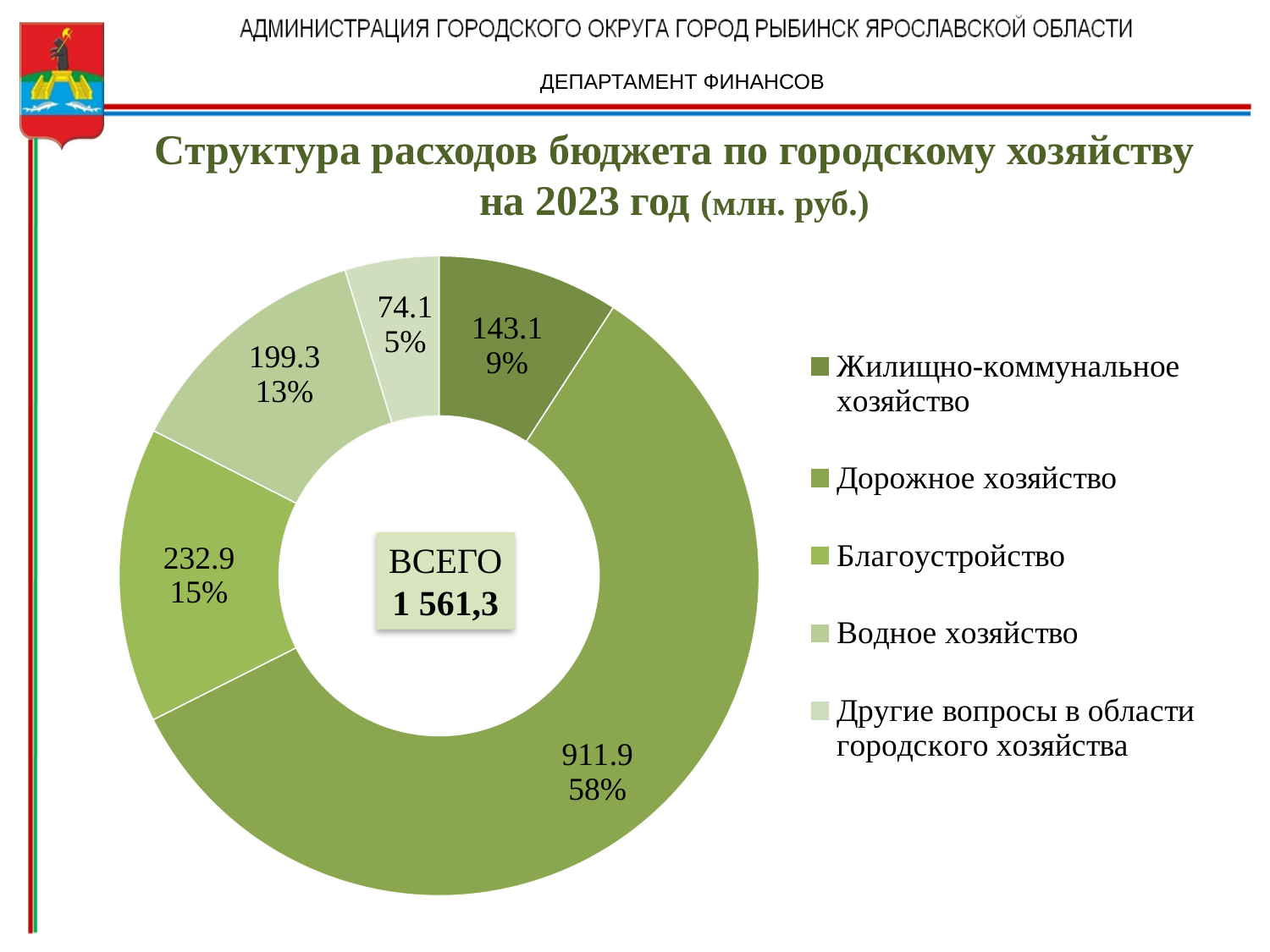
What total (ВСЕГО) is shown in the centre of the chart? 1 561,3 What is the difference between the values for Благоустройство and Водное хозяйство? 33.6 How many categories does the chart show? 5 What is the value for Дорожное хозяйство? 911.9 What share of the chart does Водное хозяйство represent? 13% Which is larger, the value for Жилищно-коммунальное хозяйство or the value for Водное хозяйство? Водное хозяйство What is the value for Жилищно-коммунальное хозяйство? 143.1 Which category has the largest value? Дорожное хозяйство Which category has the smallest value? Другие вопросы в области городского хозяйства What share of the chart does Другие вопросы в области городского хозяйства represent? 5% What type of chart is shown on the slide? Doughnut (pie) chart What is the value for Благоустройство? 232.9